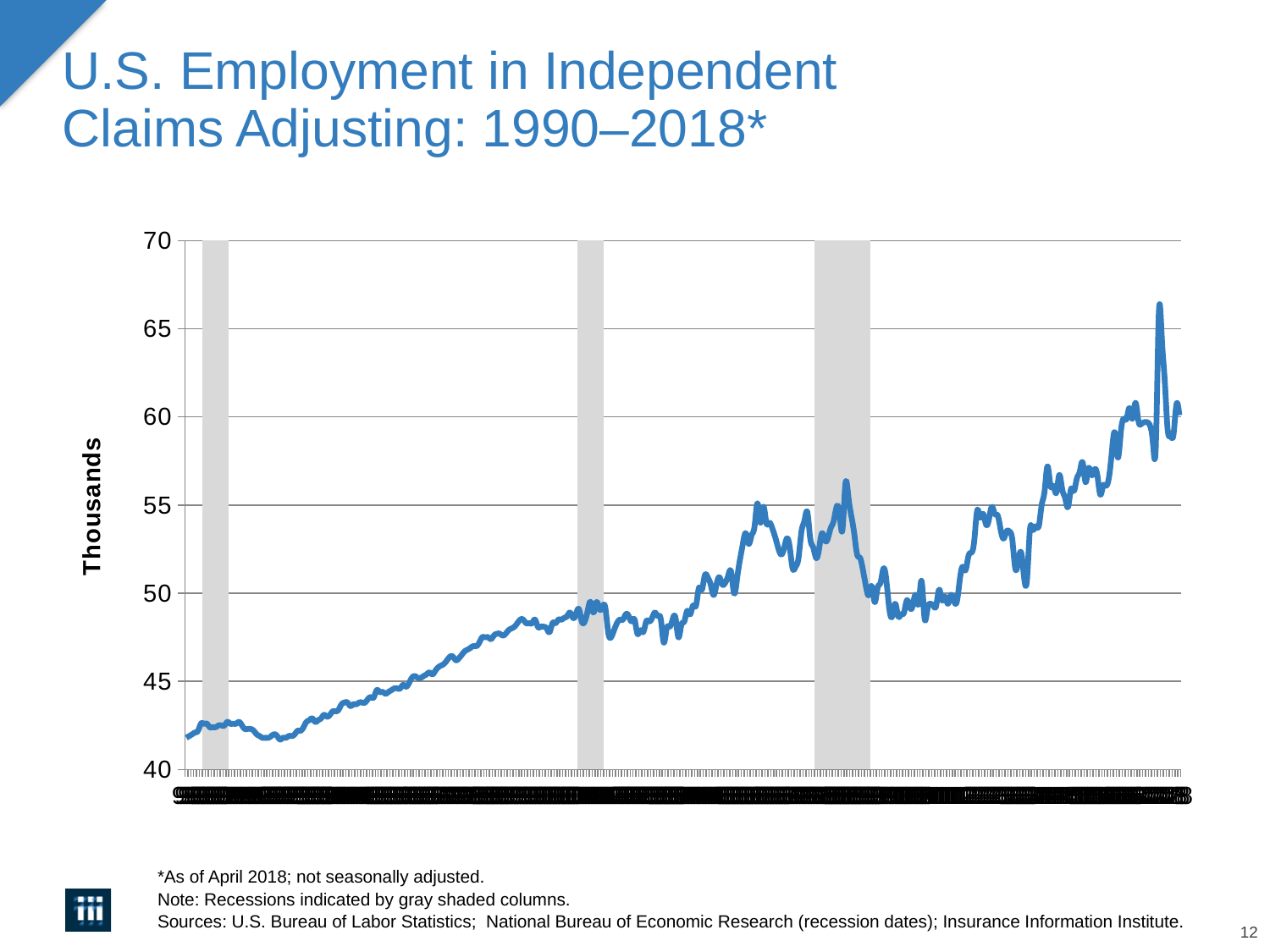
Is the lowest point of the line greater or less than 45? less How many gray shaded recession columns are shown on the chart? 3 What is the label on the vertical axis of the chart? Thousands Is the value at the far right end of the line greater or less than 55? greater What is the highest value shown on the vertical axis of the chart? 70 Overall, do the values rise or fall from the left to the right of the chart? rise Is the highest point reached by the line greater or less than 65? greater Which is larger, the value at the start of the line on the left or the value at the end of the line on the right? the value at the end on the right What kind of chart is shown on the slide? line chart What is the title of the chart on the slide? U.S. Employment in Independent Claims Adjusting: 1990–2018*